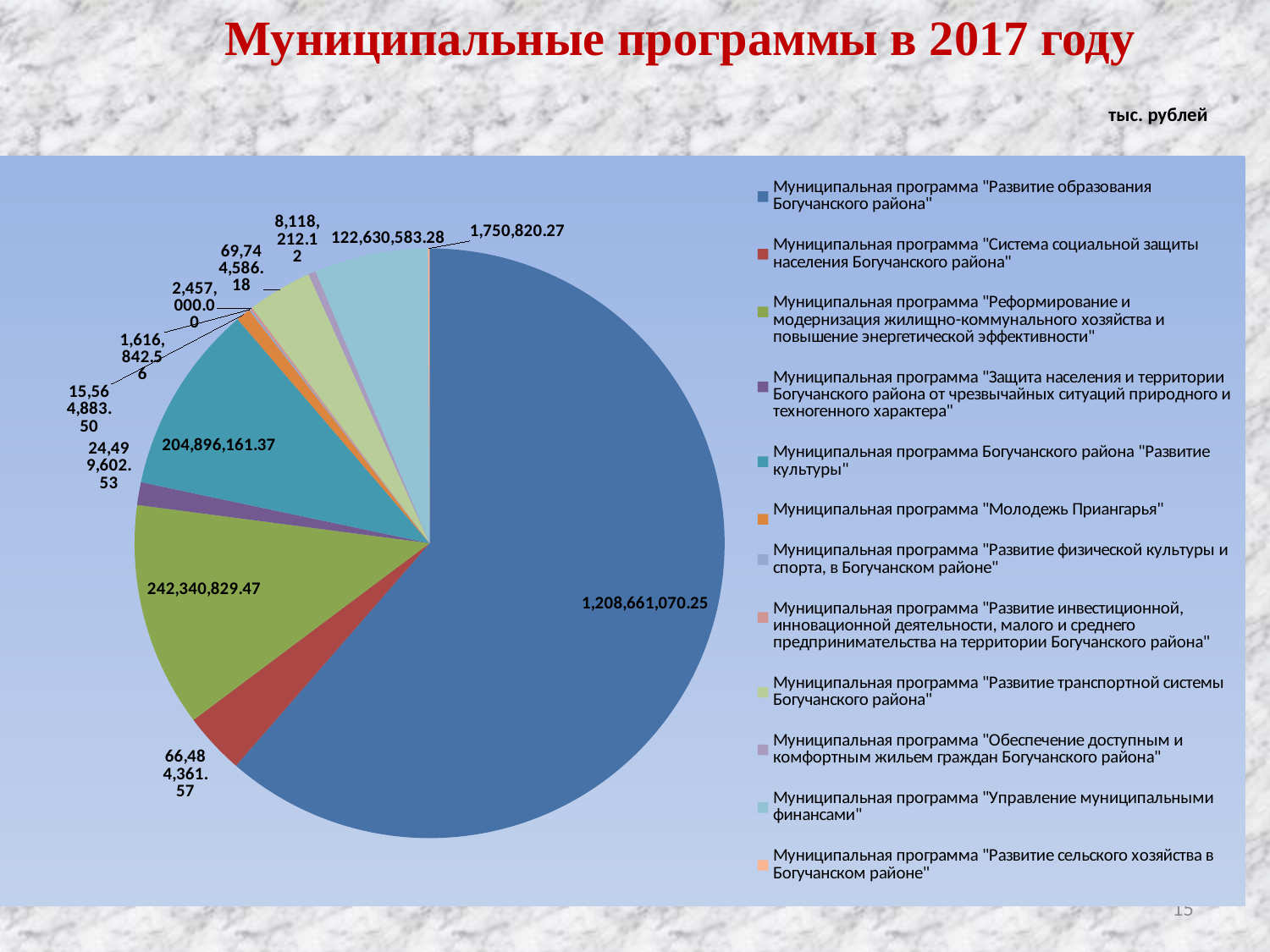
What is the value for the programme "Развитие культуры"? 204,896,161.37 What is the value for the programme "Реформирование и модернизация жилищно-коммунального хозяйства и повышение энергетической эффективности"? 242,340,829.47 What is the difference between the value for "Реформирование и модернизация жилищно-коммунального хозяйства" (242,340,829.47) and the value for "Развитие культуры" (204,896,161.37)? 37,444,668.10 What is the title of the chart on the slide? Муниципальные программы в 2017 году In what units are the chart values given, according to the slide? тыс. рублей What is the value for the programme "Система социальной защиты населения Богучанского района"? 66,484,361.57 What type of chart is shown on the slide? pie chart How many municipal programmes does the legend list? 12 What is the value for the programme "Развитие образования Богучанского района"? 1,208,661,070.25 What is the value for the programme "Управление муниципальными финансами"? 122,630,583.28 Which programme has the largest slice of the pie? Муниципальная программа "Развитие образования Богучанского района" Which is larger: the value for "Реформирование и модернизация жилищно-коммунального хозяйства" or the value for "Развитие культуры"? Реформирование и модернизация жилищно-коммунального хозяйства